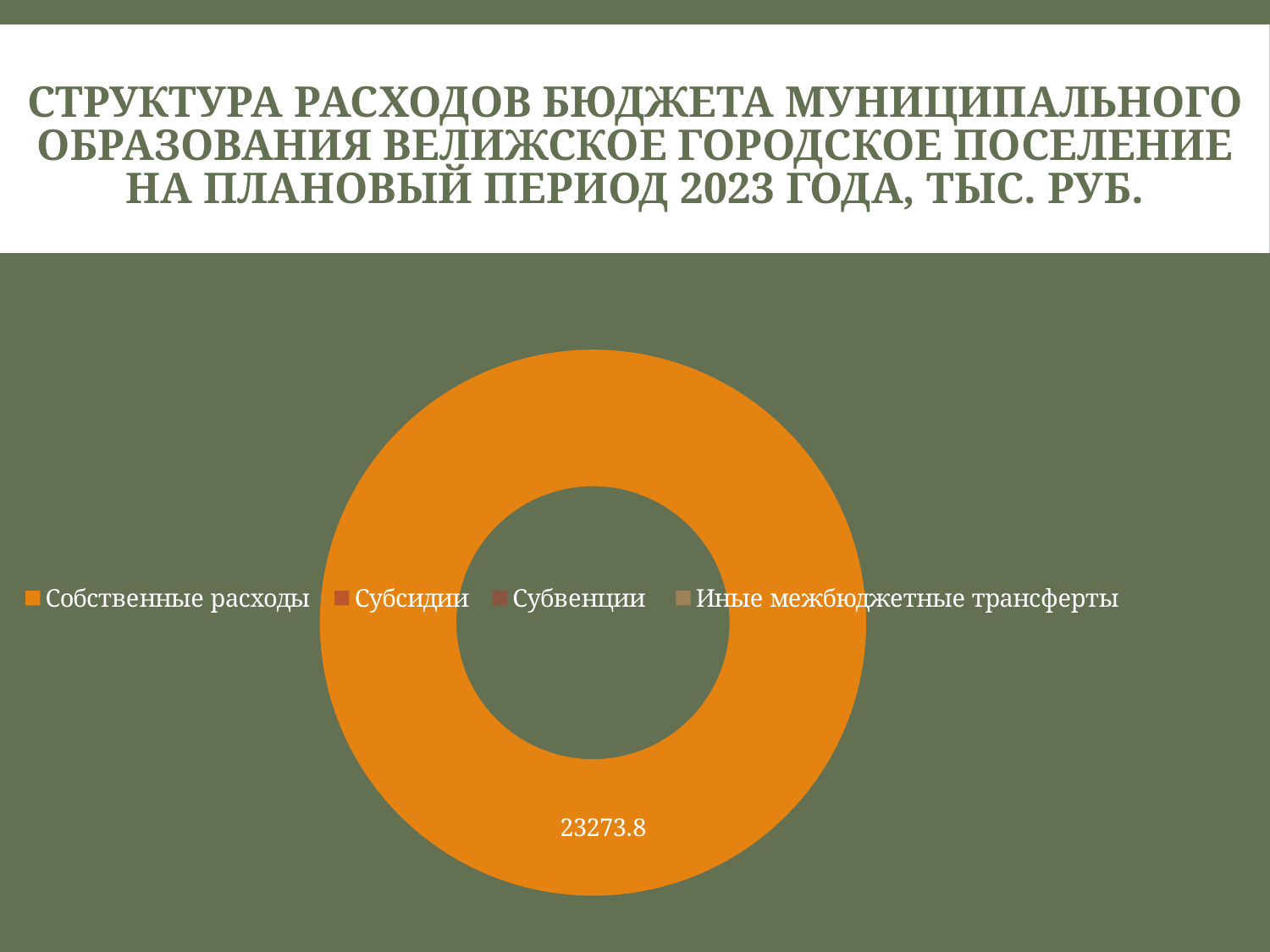
How many entries does the chart legend list? 4 What unit of measurement is stated in the chart title? тыс. руб. What value is shown for Собственные расходы on the chart? 23273.8 Which legend entry is shown in orange? Собственные расходы Is the value for Собственные расходы greater or less than 20000? greater What kind of chart is shown on the slide? Doughnut (pie) chart How many slices are visibly plotted on the doughnut chart? 1 Which category accounts for the largest part of the chart? Собственные расходы